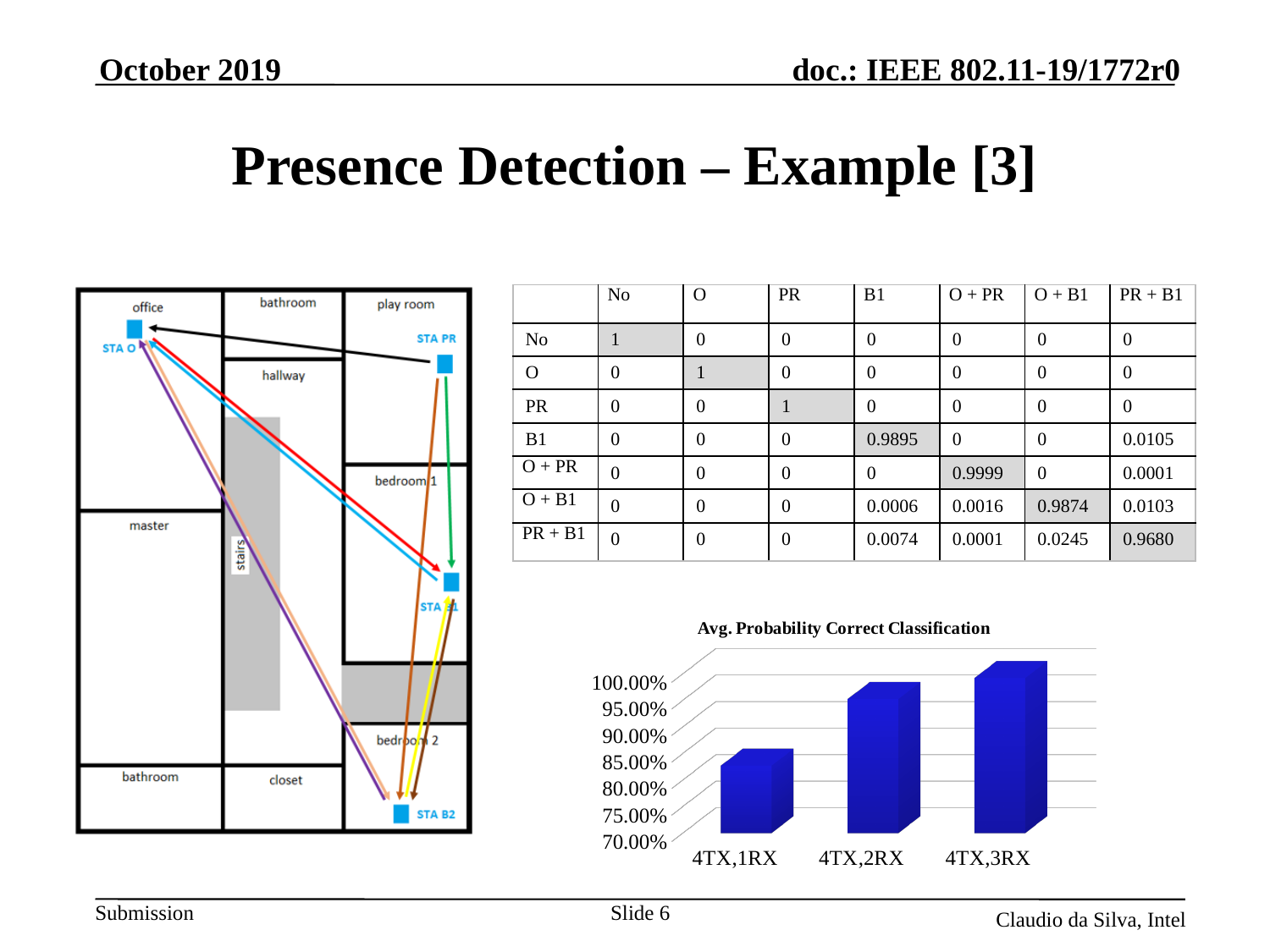
Which is larger, the value for 4TX,2RX or the value for 4TX,1RX? 4TX,2RX Is the value for 4TX,1RX greater or less than 90.00%? less Which is larger, the value for 4TX,3RX or the value for 4TX,2RX? 4TX,3RX Which category has the highest value in the chart? 4TX,3RX Which category has the lowest value in the chart? 4TX,1RX Is the value for 4TX,2RX greater or less than 90.00%? greater Is the value for 4TX,3RX greater or less than 95.00%? greater What kind of chart is shown on the slide? bar chart Do the values rise or fall from 4TX,1RX to 4TX,3RX along the x axis? rise How many categories are plotted in the chart? 3 What is the title of the chart on the slide? Avg. Probability Correct Classification